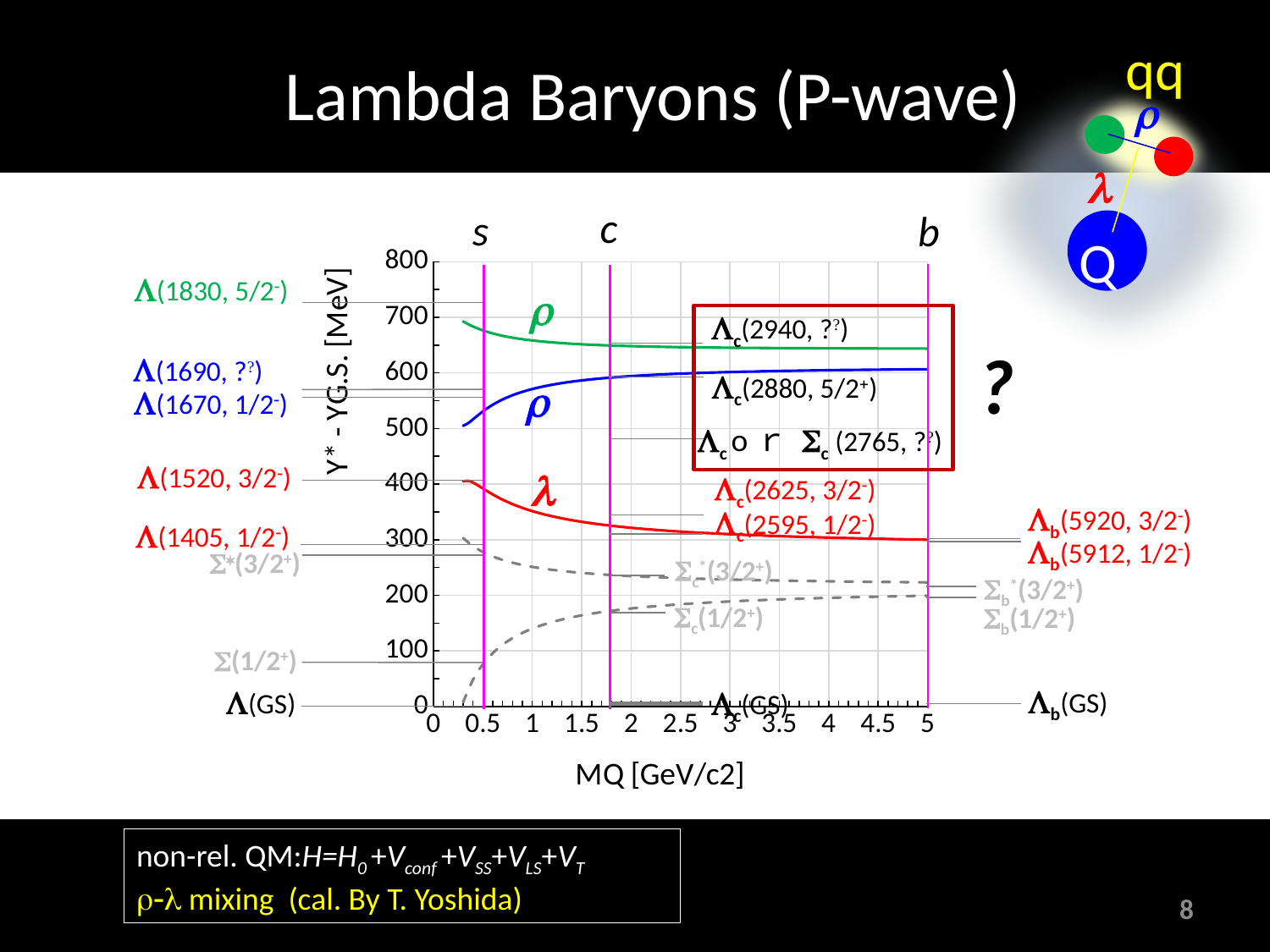
At MQ = 5, which curve is higher, the green ρ curve or the red λ curve? green ρ curve Does the red λ curve rise or fall as MQ increases? fall Does the green ρ curve rise or fall as MQ increases? fall Is the value of the green ρ curve at the s line (MQ = 0.5) greater or less than 600? greater Does the blue ρ curve rise or fall as MQ increases? rise How many vertical magenta marker lines (labelled s, c, b) are drawn on the chart? 3 Is the value of the green ρ curve at MQ = 5 greater or less than 600? greater Is the value of the blue ρ curve at MQ = 5 greater or less than 500? greater What kind of chart is shown on the slide? line chart What is the label of the x axis of the chart? MQ [GeV/c2] What is the label of the y axis of the chart? Y* - YG.S. [MeV]